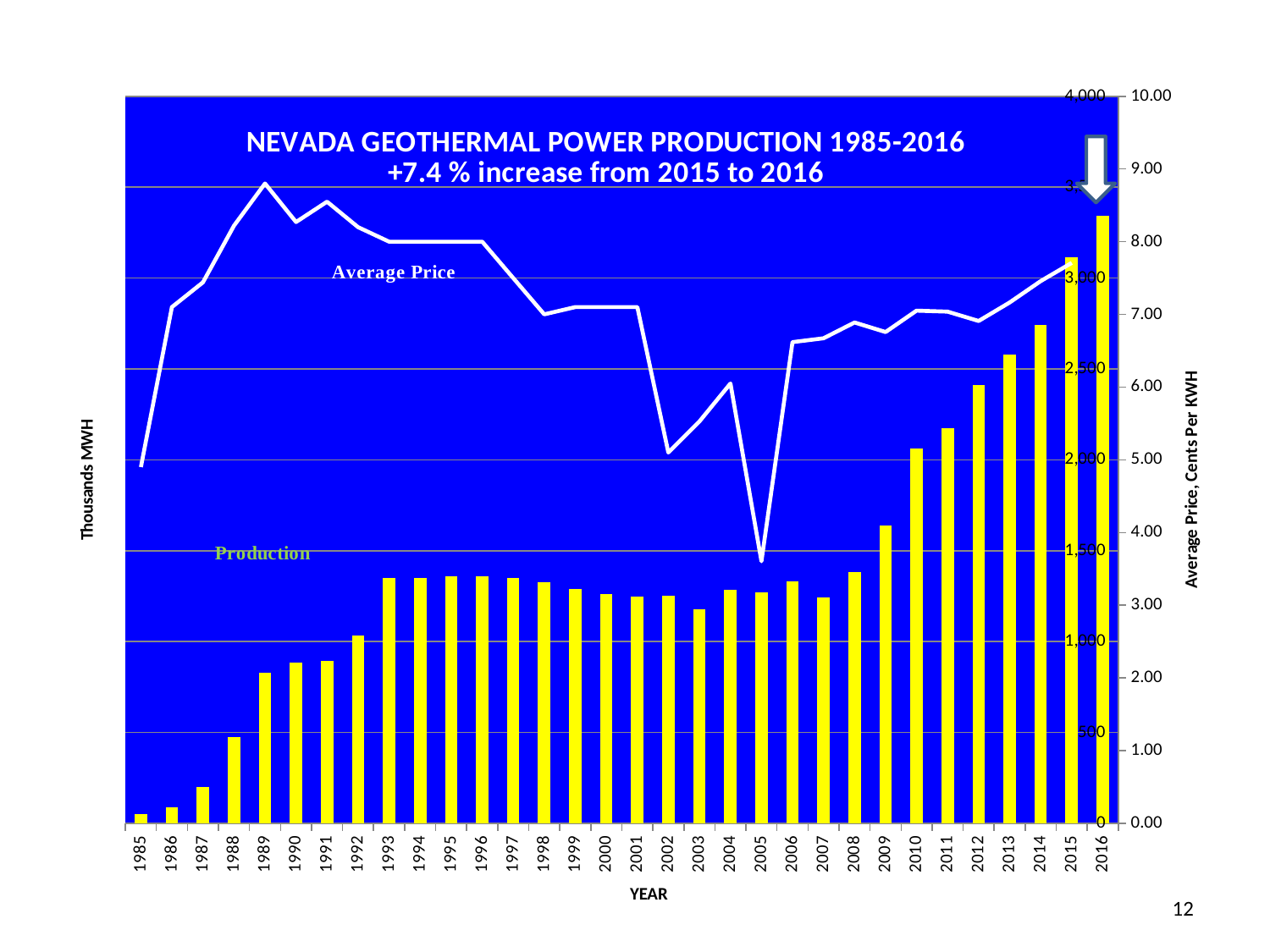
Is the Average Price for 2005 greater or less than 4.00 cents per KWH? less In which year is Production highest? 2016 Which year has the higher Average Price, 2001 or 2002? 2001 According to the chart subtitle, what was the percentage increase in production from 2015 to 2016? +7.4 % In which year is Production lowest? 1985 In which year is the Average Price lowest? 2005 What is the title of the chart? NEVADA GEOTHERMAL POWER PRODUCTION 1985-2016 How many years are plotted along the x axis? 32 Is the Production value for 2016 greater or less than 3,000 thousand MWh? greater Is the Production value for 1993 greater or less than 1,500 thousand MWh? less What kind of chart is shown on the slide? A combination bar and line chart Does Production rise or fall from 2007 to 2016? Rise